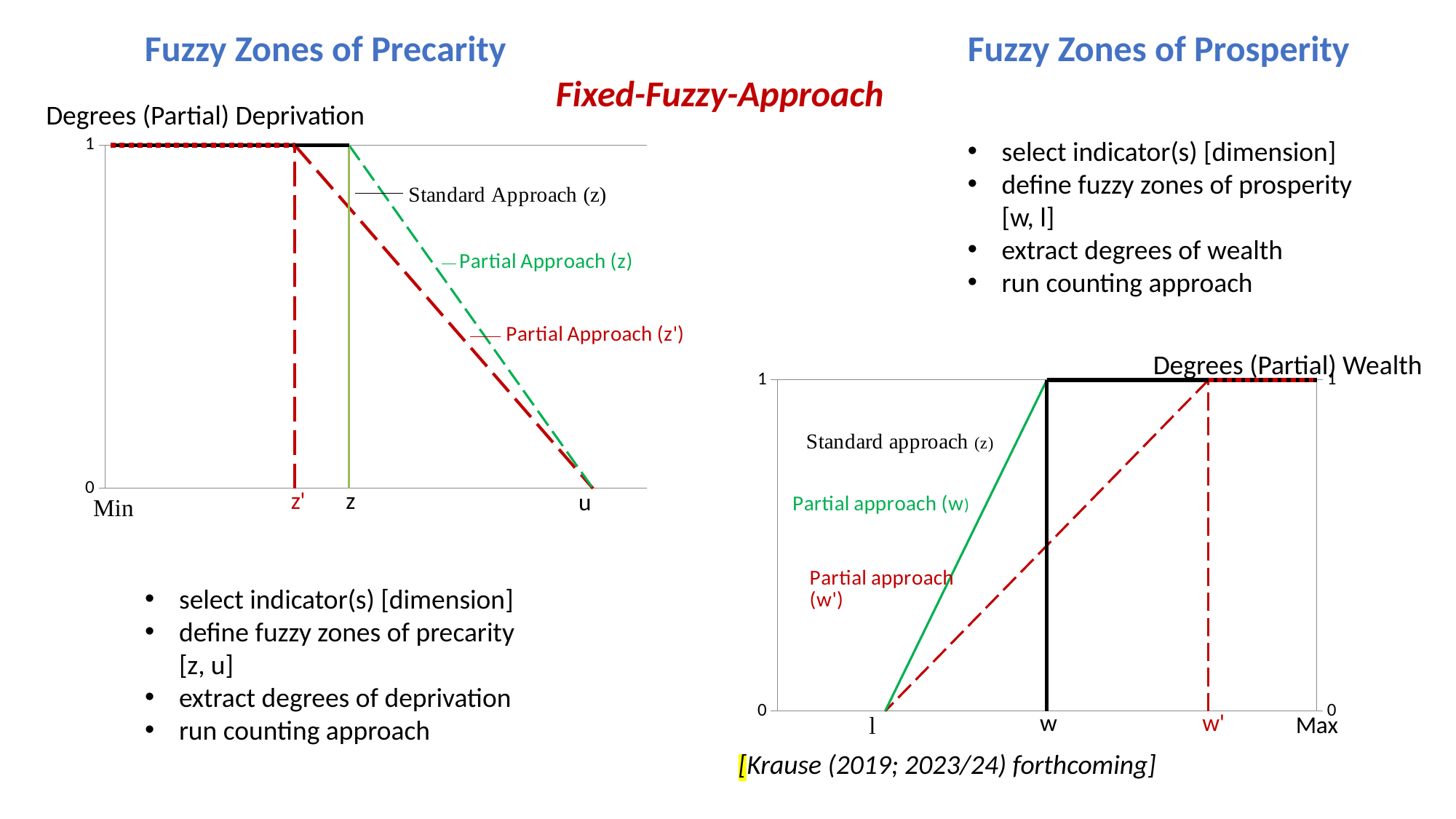
In the left chart 'Degrees (Partial) Deprivation', how many labelled points are on the x axis? 4 What kind of chart is the left chart titled 'Degrees (Partial) Deprivation'? line chart In the left chart 'Degrees (Partial) Deprivation', what is the value of the Standard Approach (z) line at Min? 1 In the right chart 'Degrees (Partial) Wealth', do the lines rise or fall between l and w? rise In the left chart 'Degrees (Partial) Deprivation', how many approaches (lines) are labelled? 3 In the left chart 'Degrees (Partial) Deprivation', do the lines rise or fall between z and u? fall In the left chart 'Degrees (Partial) Deprivation', what value do the Partial Approach lines reach at u? 0 In the right chart 'Degrees (Partial) Wealth', what is the value of the Partial approach (w) line at l? 0 In the right chart 'Degrees (Partial) Wealth', how many labelled points are on the x axis? 4 In the right chart 'Degrees (Partial) Wealth', what is the value of the Standard approach line at Max? 1 In the left chart 'Degrees (Partial) Deprivation', what colour is the Partial Approach (z') line? red In the right chart 'Degrees (Partial) Wealth', what colour is the Partial approach (w) line? green